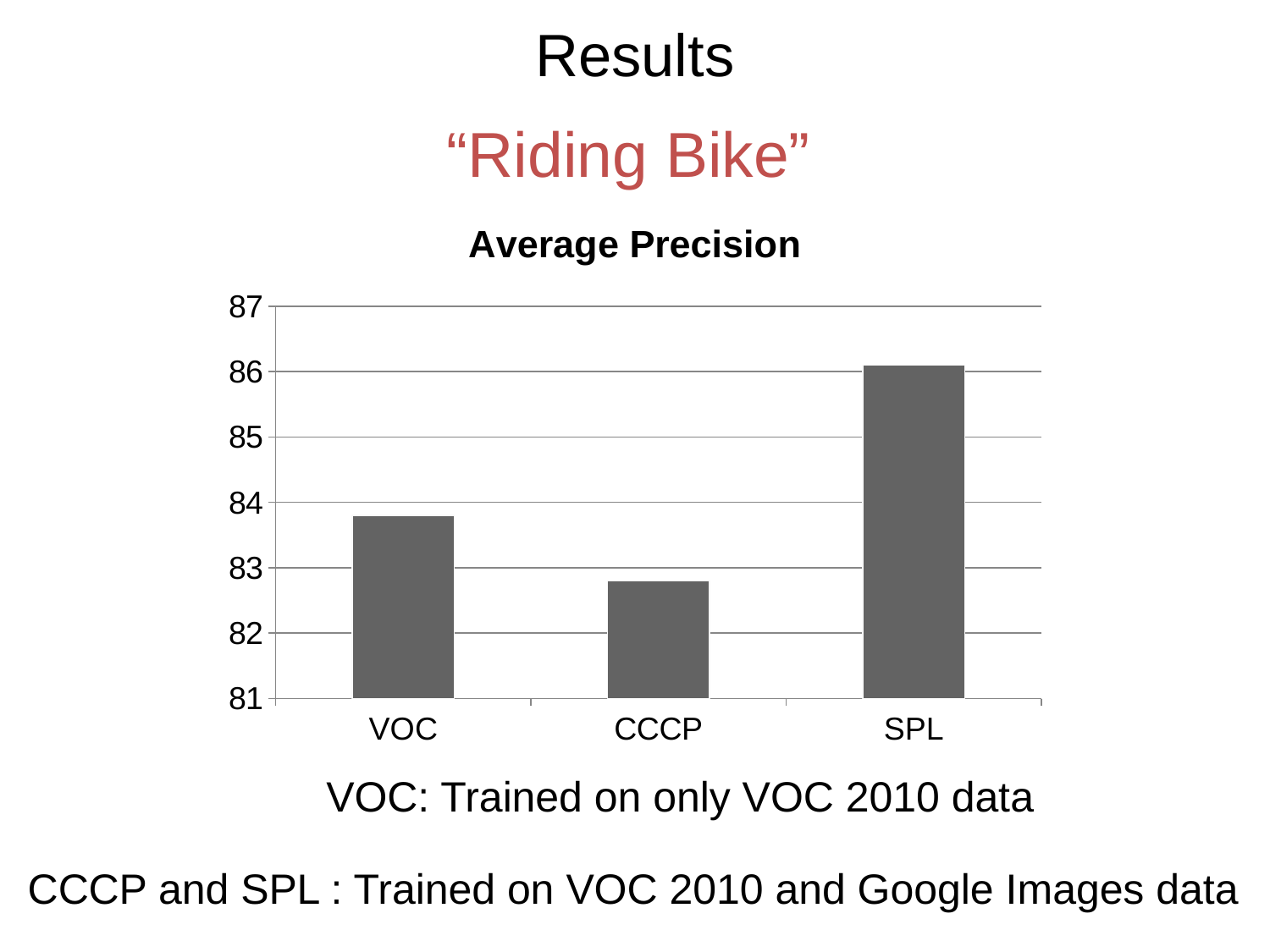
Is the value for CCCP greater or less than 82? greater Is the value for VOC greater or less than 83? greater Which has a higher average precision, VOC or CCCP? VOC Is the value for VOC greater or less than 84? less What type of chart is shown on the slide? bar chart Which category has the highest average precision? SPL Which has a higher average precision, SPL or VOC? SPL Which category has the lowest average precision? CCCP How many categories are shown on the x axis of the chart? 3 What is the title of the chart? Average Precision